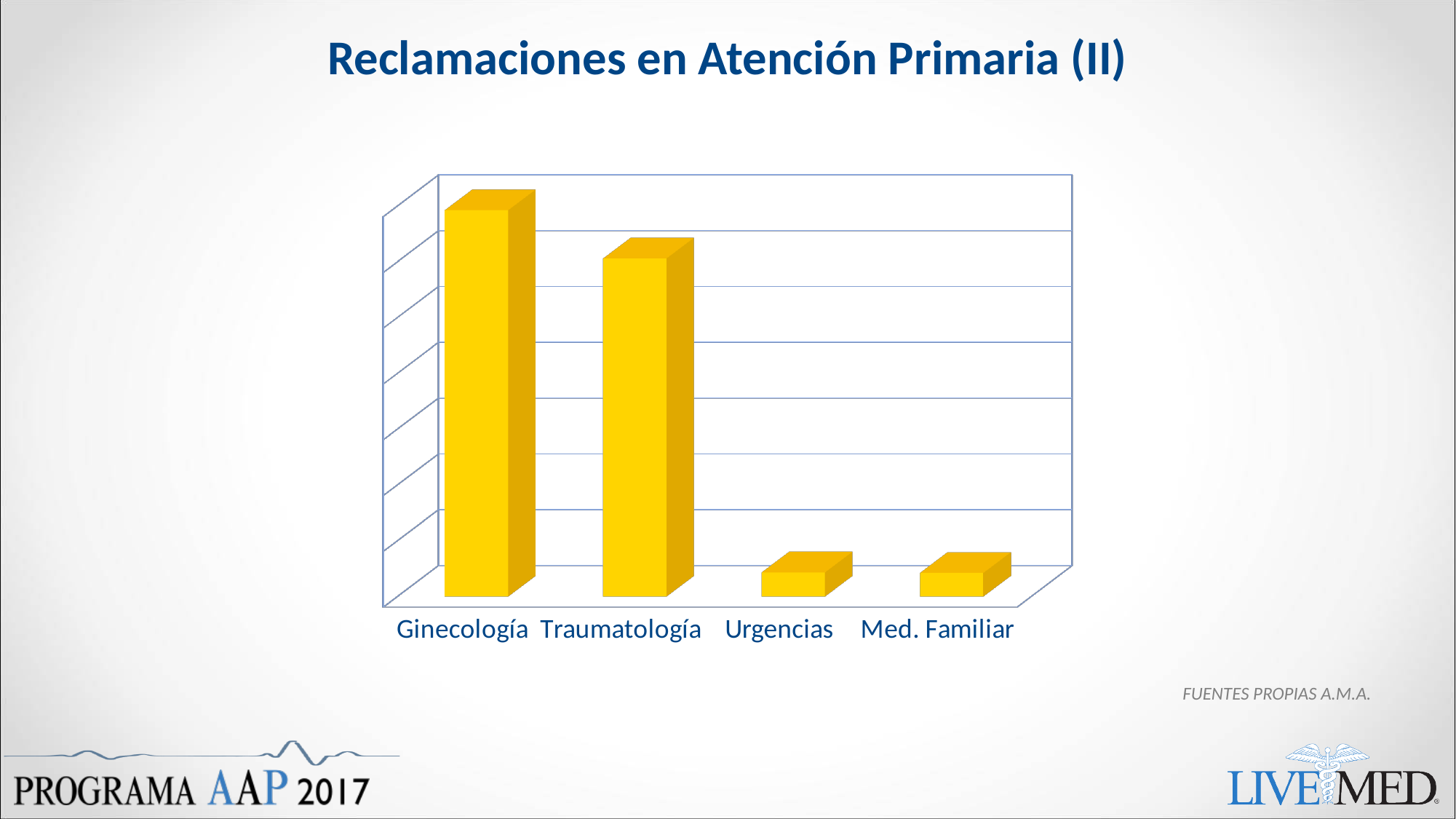
Do the bar heights generally rise or fall from left to right across the categories? Fall What is the label of the rightmost category on the x axis? Med. Familiar What kind of chart is shown on the slide? Bar chart Which bar is taller, Traumatología or Urgencias? Traumatología How many categories are shown on the x axis of the chart? 4 What is the title of the slide containing the chart? Reclamaciones en Atención Primaria (II) Which bar is taller, Med. Familiar or Ginecología? Ginecología Which category has the tallest bar after Ginecología? Traumatología What is the label of the third category from the left on the x axis? Urgencias Which category has the highest bar in the chart? Ginecología What colour are the bars in the chart? Yellow